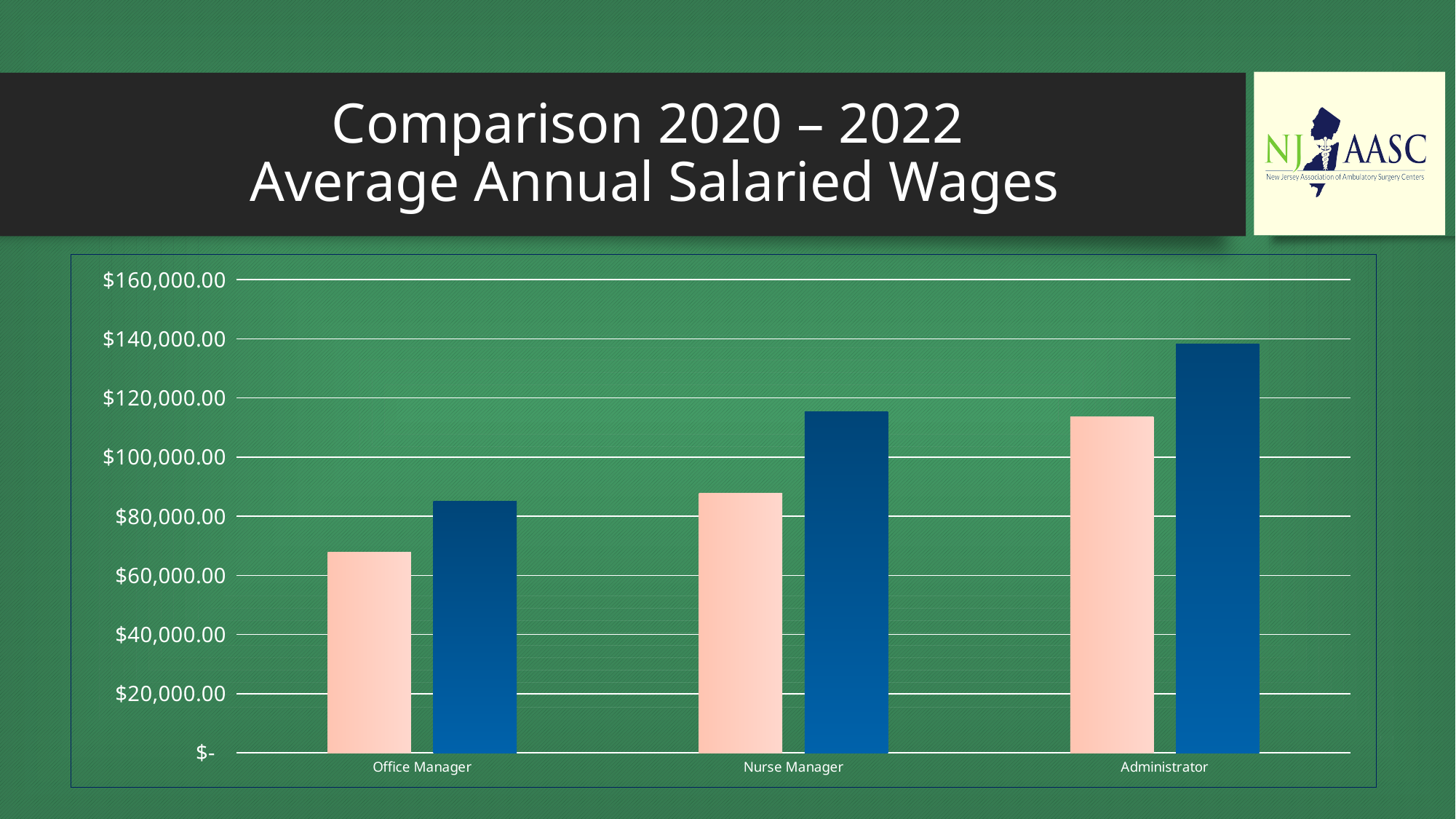
Is the light peach bar for Nurse Manager greater or less than $100,000.00? less Which is larger: the dark blue bar for Nurse Manager or the dark blue bar for Administrator? Administrator Is the dark blue bar for Nurse Manager greater or less than $100,000.00? greater What is the title of the slide containing the chart? Comparison 2020 – 2022 Average Annual Salaried Wages Do the bar heights rise or fall moving from Office Manager to Administrator along the x axis? rise Is the dark blue bar for Office Manager greater or less than $100,000.00? less Which category has the tallest dark blue bar? Administrator How many job categories are shown on the x axis of the chart? 3 Which category has the shortest light peach bar? Office Manager What kind of chart is shown on the slide? bar chart